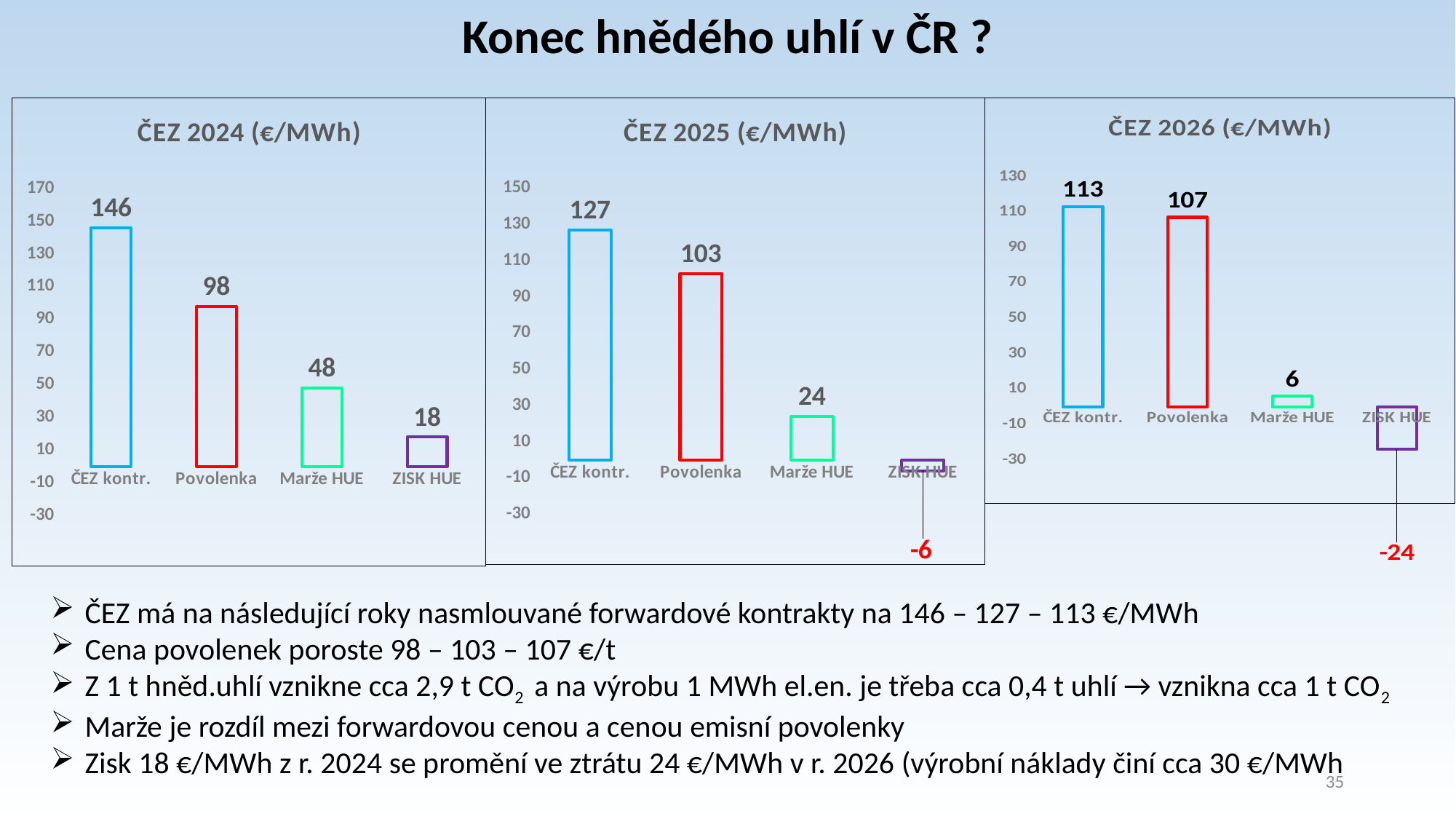
How many charts are shown on the slide? 3 In the ČEZ 2024 (€/MWh) chart, which category has the highest value? ČEZ kontr. In the ČEZ 2025 (€/MWh) chart, what is the value for Povolenka? 103 In the ČEZ 2025 (€/MWh) chart, what is the difference between ČEZ kontr. and Povolenka? 24 In the ČEZ 2026 (€/MWh) chart, what is the value for ZISK HUE? -24 In the ČEZ 2024 (€/MWh) chart, what is the value for ČEZ kontr.? 146 In the ČEZ 2024 (€/MWh) chart, what is the value for Marže HUE? 48 In the ČEZ 2026 (€/MWh) chart, which category has the lowest value? ZISK HUE What type of chart is the ČEZ 2025 (€/MWh) chart? Bar chart In the ČEZ 2025 (€/MWh) chart, what is the value for ZISK HUE? -6 In the ČEZ 2026 (€/MWh) chart, which is larger, ČEZ kontr. or Povolenka? ČEZ kontr. How many categories are shown in the ČEZ 2024 (€/MWh) chart? 4